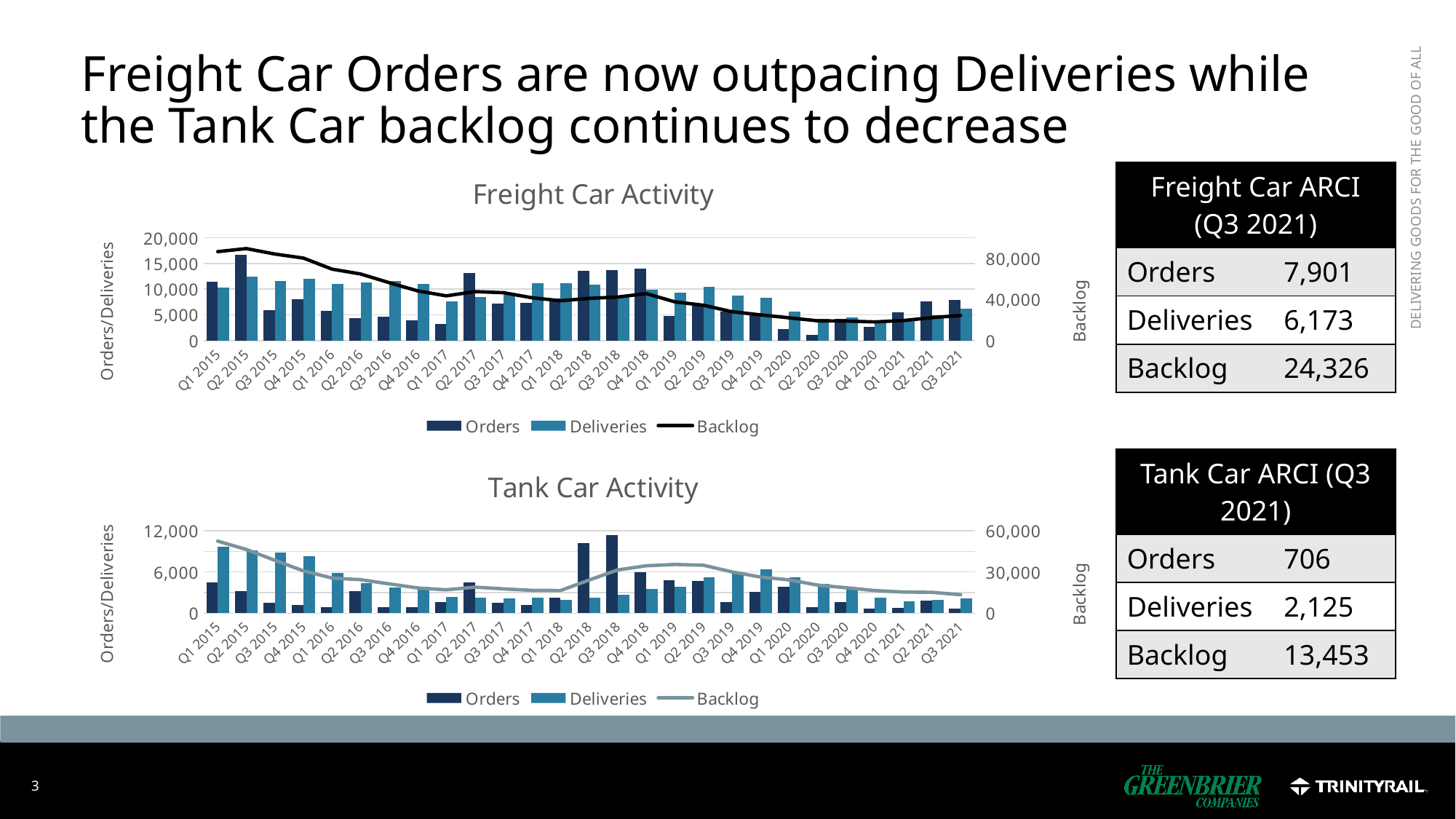
In the Freight Car Activity chart, which quarter has the highest Orders bar? Q2 2015 In the Freight Car Activity chart, is the Orders value for Q2 2020 greater or less than 5,000? less In the Freight Car Activity chart, does the Backlog line rise or fall overall from Q1 2015 to Q3 2021? Fall In the Tank Car Activity chart, which quarter has the highest Orders bar? Q3 2018 How many series does the legend of the Tank Car Activity chart list? 3 What kind of chart is the Freight Car Activity chart? Bar chart with a line In the Tank Car Activity chart, is the Backlog value for Q1 2015 greater or less than 30,000? greater How many quarters are plotted on the x axis of the Freight Car Activity chart? 27 In the Freight Car Activity chart, which is larger for Q3 2021: Orders or Deliveries? Orders In the Freight Car Activity chart, is the Orders value for Q2 2015 greater or less than 15,000? greater In the Tank Car Activity chart, does the Backlog line rise or fall from Q1 2019 to Q3 2021? Fall In the Tank Car Activity chart, which is larger for Q3 2021: Orders or Deliveries? Deliveries